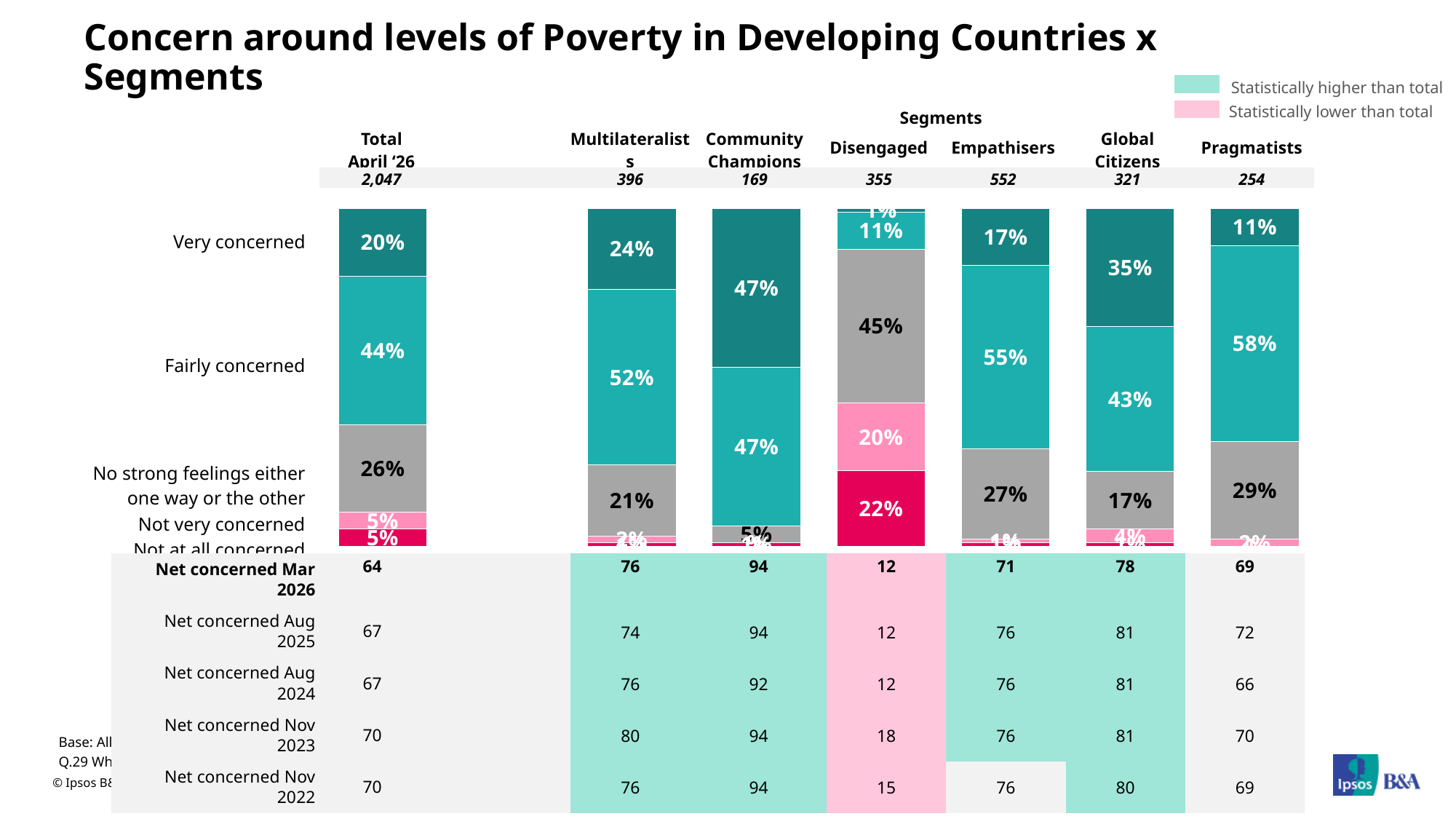
Which segment has the lowest share of Fairly concerned respondents? Disengaged How many percentage points higher is the Fairly concerned share for Multilateralists than for the Total? 8 percentage points How many stacked bars are shown in the chart, including the Total? 7 Which has a larger Very concerned share, Multilateralists or Empathisers? Multilateralists What percentage of Pragmatists are Fairly concerned? 58% What type of chart is used to show the concern levels? Stacked bar chart What is the base size shown for the Empathisers segment? 552 What percentage of the Disengaged segment have no strong feelings either one way or the other? 45% What is the Net concerned Mar 2026 figure for Community Champions? 94 What percentage of the Disengaged segment are Not at all concerned? 22% Which segment has the highest share of Very concerned respondents? Community Champions What percentage of the Total (April '26) are Very concerned? 20%